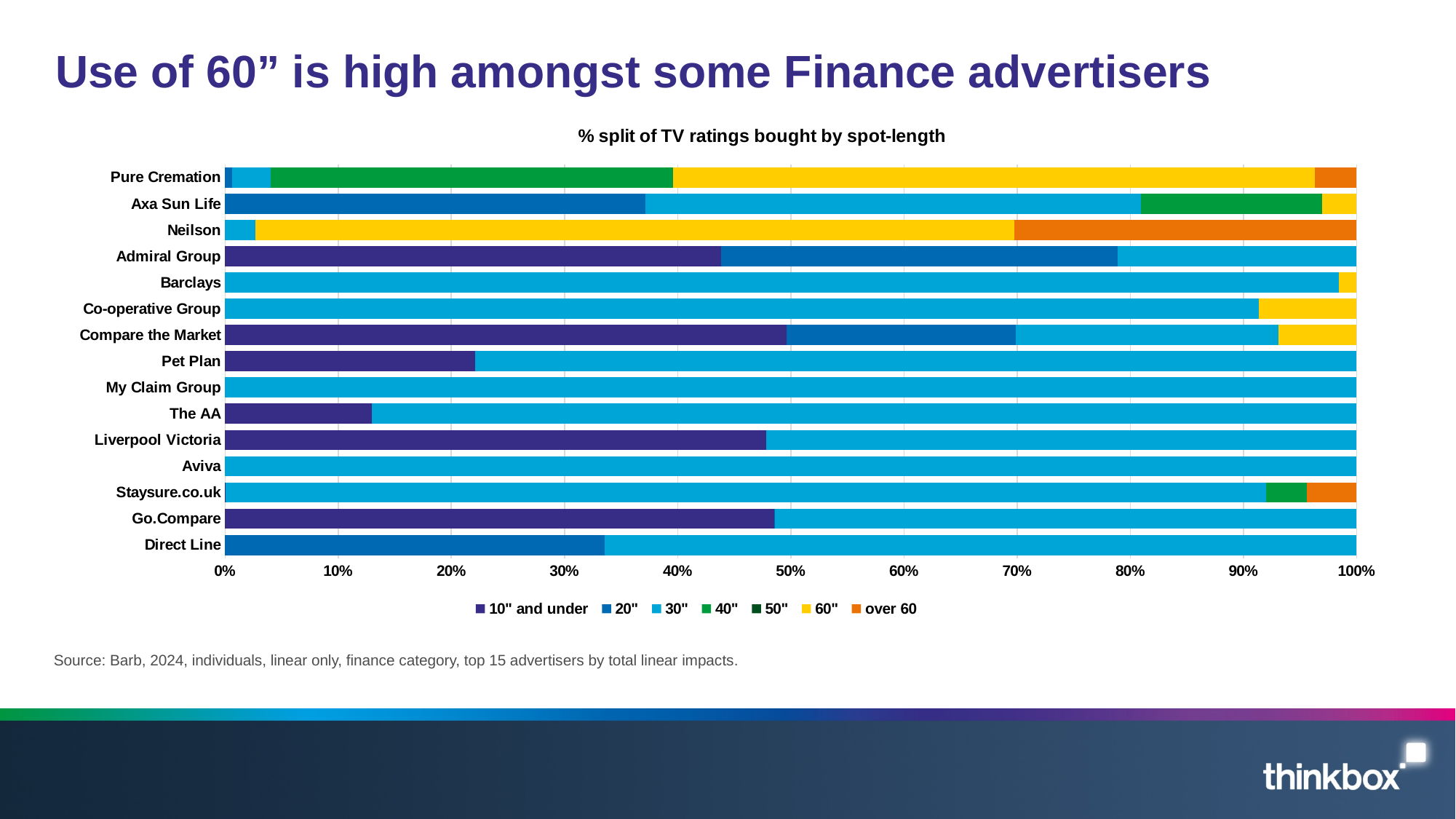
Is the 60" share for Pure Cremation greater or less than 50%? greater How many advertisers are listed on the chart? 15 Is the 10" and under share for Admiral Group greater or less than 40%? greater Which has the larger 10" and under share, Admiral Group or The AA? Admiral Group What kind of chart is shown on the slide? Stacked bar chart Is the 20" share for Direct Line greater or less than 30%? greater Which spot-length series is shown in yellow in the legend? 60" How many spot-length series does the legend list? 7 Which advertiser has the largest over 60 share? Neilson What is the title of the chart? % split of TV ratings bought by spot-length